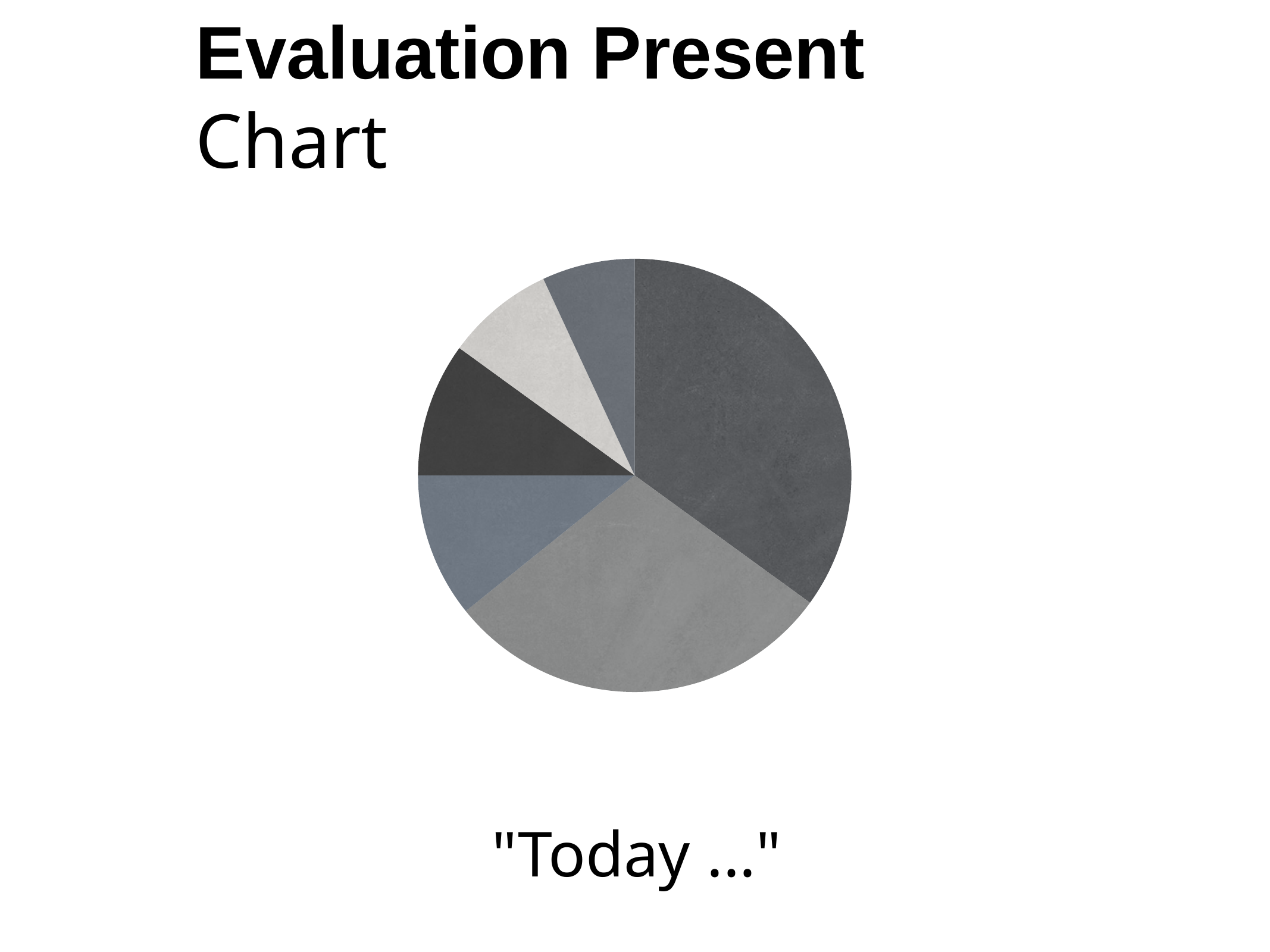
What kind of chart is shown on the slide? pie chart What is the title of the slide containing the pie chart? Evaluation Present Chart What text appears below the pie chart? "Today ..." Which is larger: the dark slate slice on the right or the light grey slice at the top left? the dark slate slice on the right Which slice of the pie chart is the largest? the dark slate slice on the right Which is larger: the medium grey slice at the bottom or the blue-grey slice on the left? the medium grey slice at the bottom How many slices does the pie chart have? 6